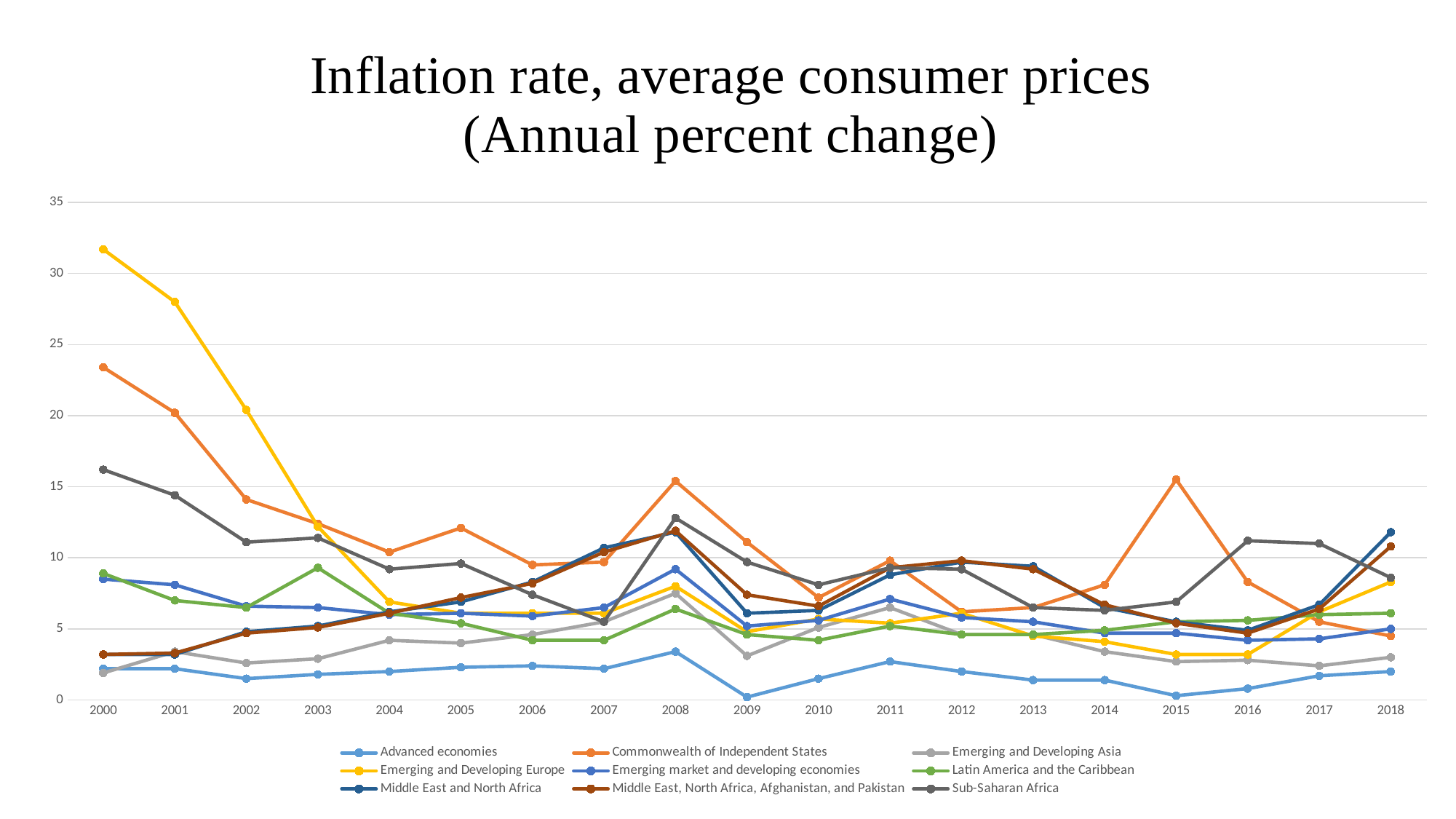
Does the Emerging and Developing Europe line rise or fall from 2000 to 2003? fall Which series has the highest value in 2015? Commonwealth of Independent States Which series has the lowest value in 2015? Advanced economies How many years are plotted along the x axis? 19 How many series does the legend list? 9 Is the value for Commonwealth of Independent States in 2000 greater or less than 20? greater In 2016, which is larger: Sub-Saharan Africa or Advanced economies? Sub-Saharan Africa What kind of chart is shown on the slide? line chart Is the value for Emerging and Developing Europe in 2000 greater or less than 30? greater Is the value for Sub-Saharan Africa in 2000 greater or less than 15? greater Which series has the highest value in 2000? Emerging and Developing Europe